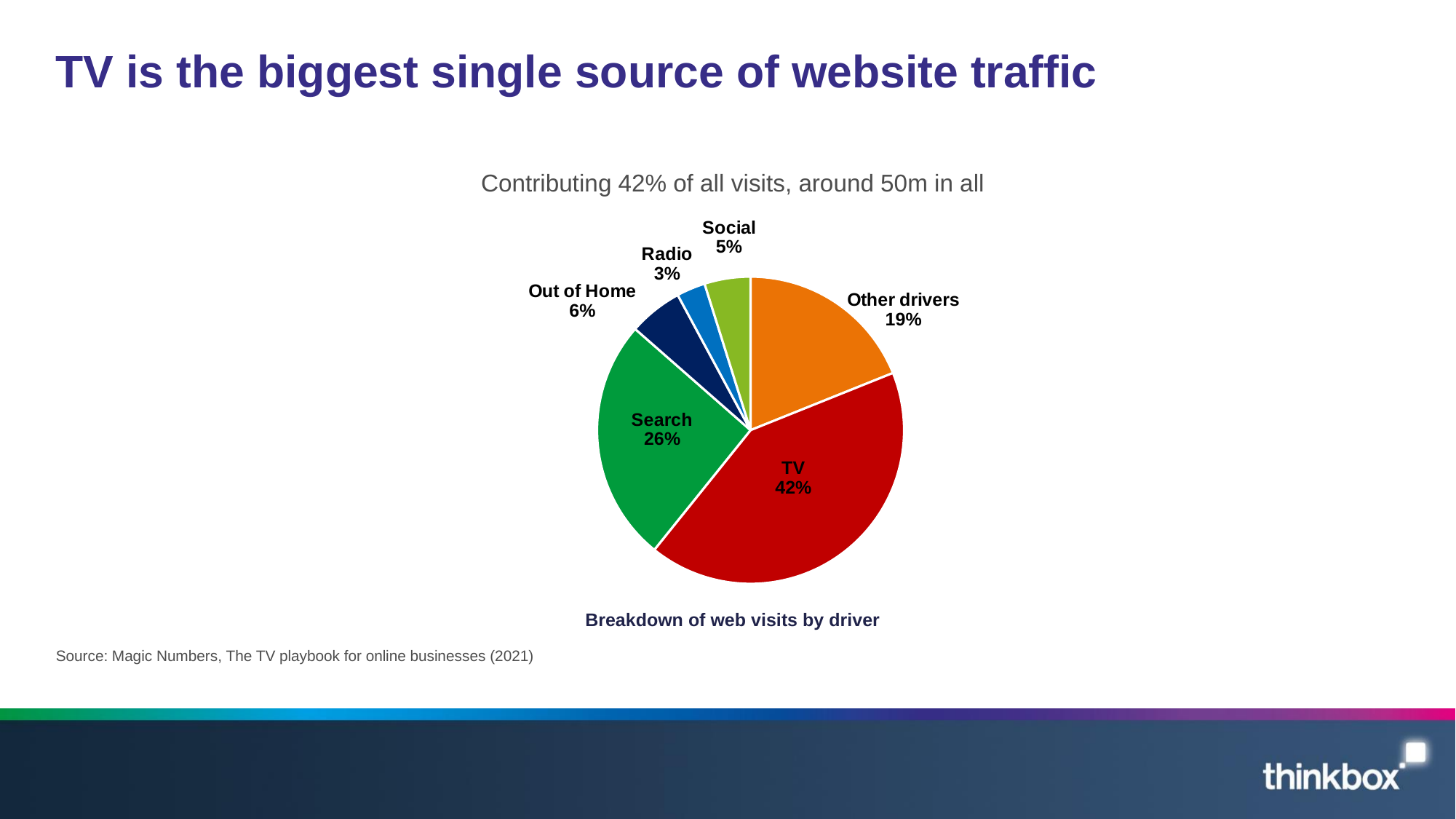
What is the title of the chart? Breakdown of web visits by driver What share of web visits comes from Other drivers? 19% What share of web visits does TV account for? 42% Which driver has the smallest share of web visits? Radio What percentage of web visits is driven by Radio? 3% Which has a larger share of web visits, Out of Home or Social? Out of Home How many drivers are shown in the pie chart? 6 What is the combined share of Out of Home, Radio and Social? 14% What percentage of web visits is attributed to Search? 26% What type of chart is used to show the breakdown of web visits by driver? Pie chart What is the difference in percentage points between TV and Search? 16 Which driver has the largest share of web visits? TV